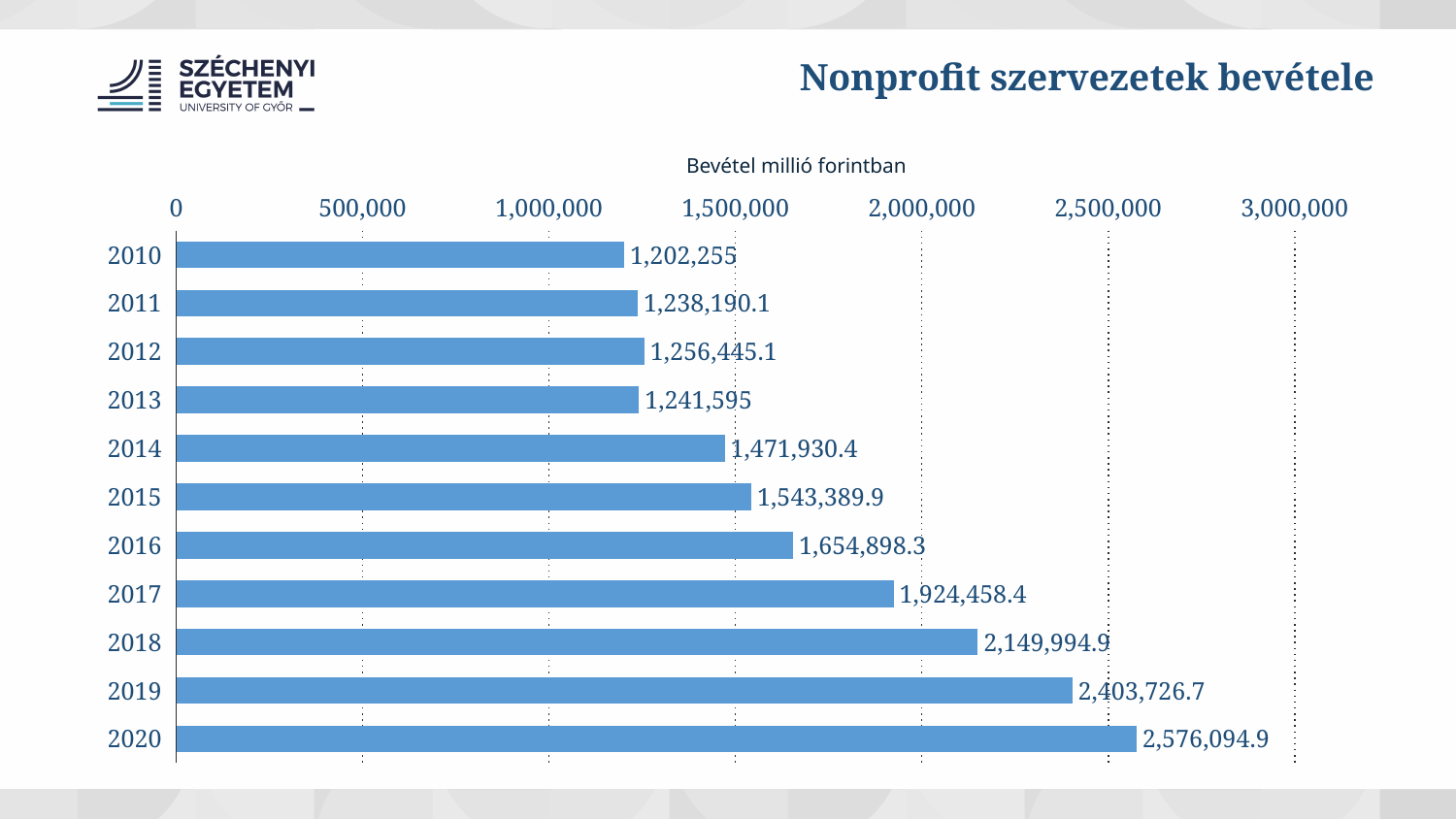
What is the value for 2016? 1,654,898.3 What is the value for 2020? 2,576,094.9 Which year has the lowest value? 2010 What is the title of the chart? Bevétel millió forintban Which year has the highest value? 2020 Which is larger, the value for 2012 or the value for 2013? 2012 What is the difference between the values for 2019 and 2018? 253,731.8 Is the value for 2017 greater or less than 2,000,000? less What kind of chart is shown on the slide? bar chart What is the value for 2010? 1,202,255 How many years are shown in the chart? 11 What is the difference between the values for 2020 and 2010? 1,373,839.9